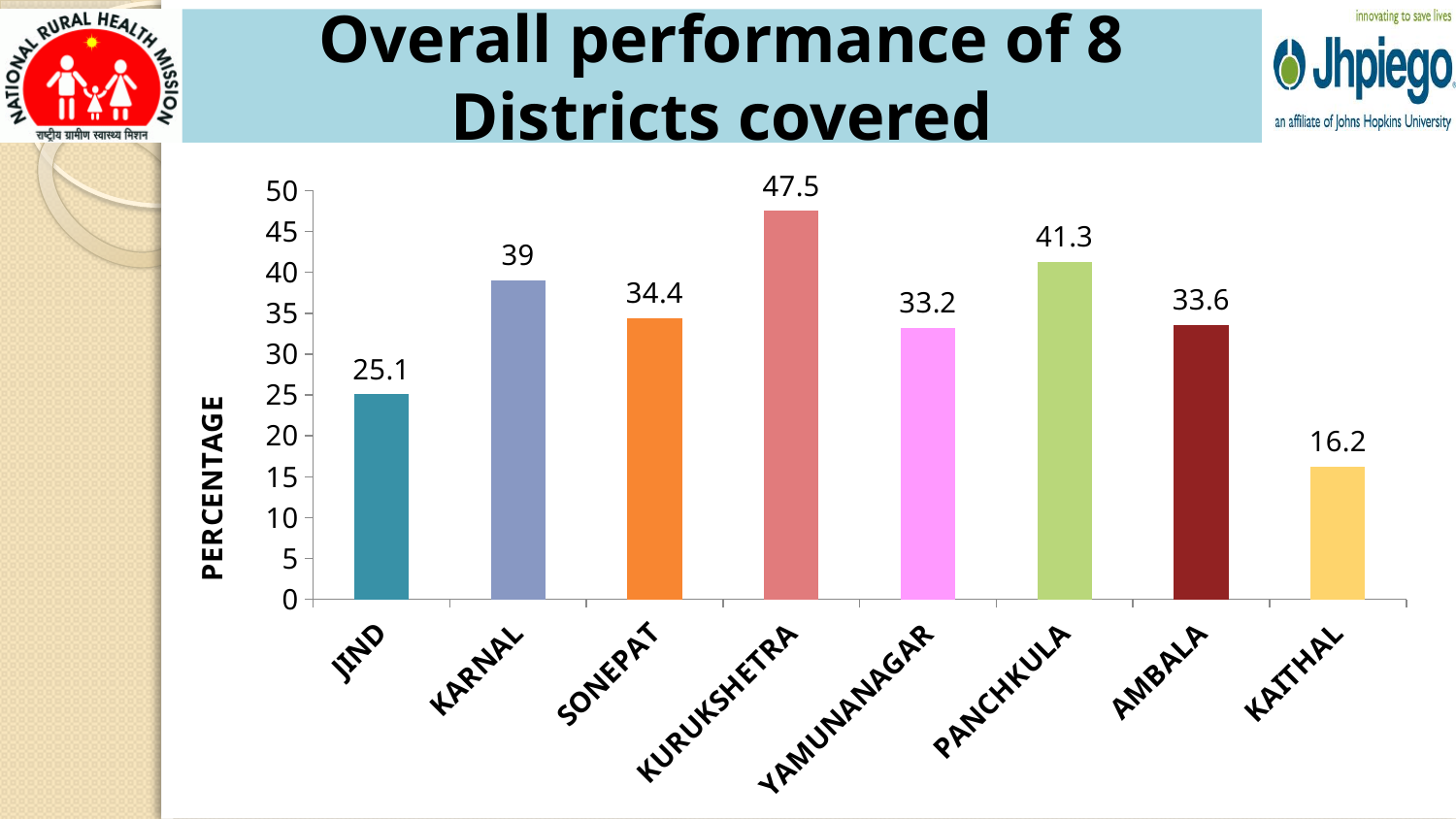
Which district has the highest percentage? KURUKSHETRA Which district has the lowest percentage? KAITHAL Is the value for JIND greater or less than 30? less What is the difference between the values for KURUKSHETRA and KAITHAL? 31.3 What is the difference between the values for PANCHKULA and JIND? 16.2 How many districts are shown on the chart? 8 What is the percentage value for KAITHAL? 16.2 What is the percentage value for KURUKSHETRA? 47.5 Which has a larger value, KARNAL or AMBALA? KARNAL What is the label of the vertical axis? PERCENTAGE What is the percentage value for SONEPAT? 34.4 What kind of chart is shown on the slide? bar chart